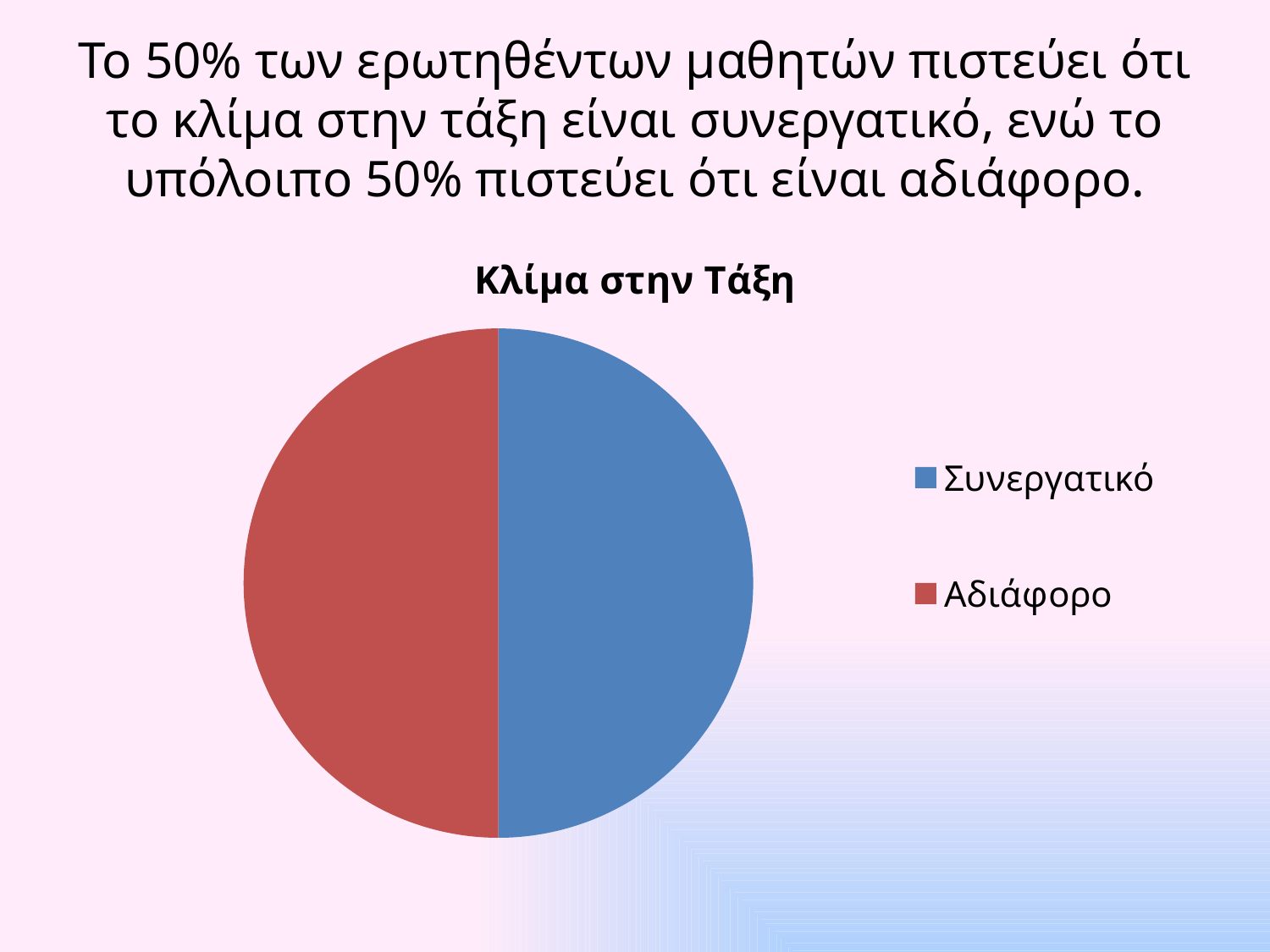
What is the title of the pie chart? Κλίμα στην Τάξη How many slices does the pie chart have? 2 How many entries does the legend of the pie chart list? 2 Which colour represents Αδιάφορο in the pie chart? red What share of the pie does the Συνεργατικό slice represent? 50% What share of the pie does the Αδιάφορο slice represent? 50% What kind of chart is shown on the slide? pie chart